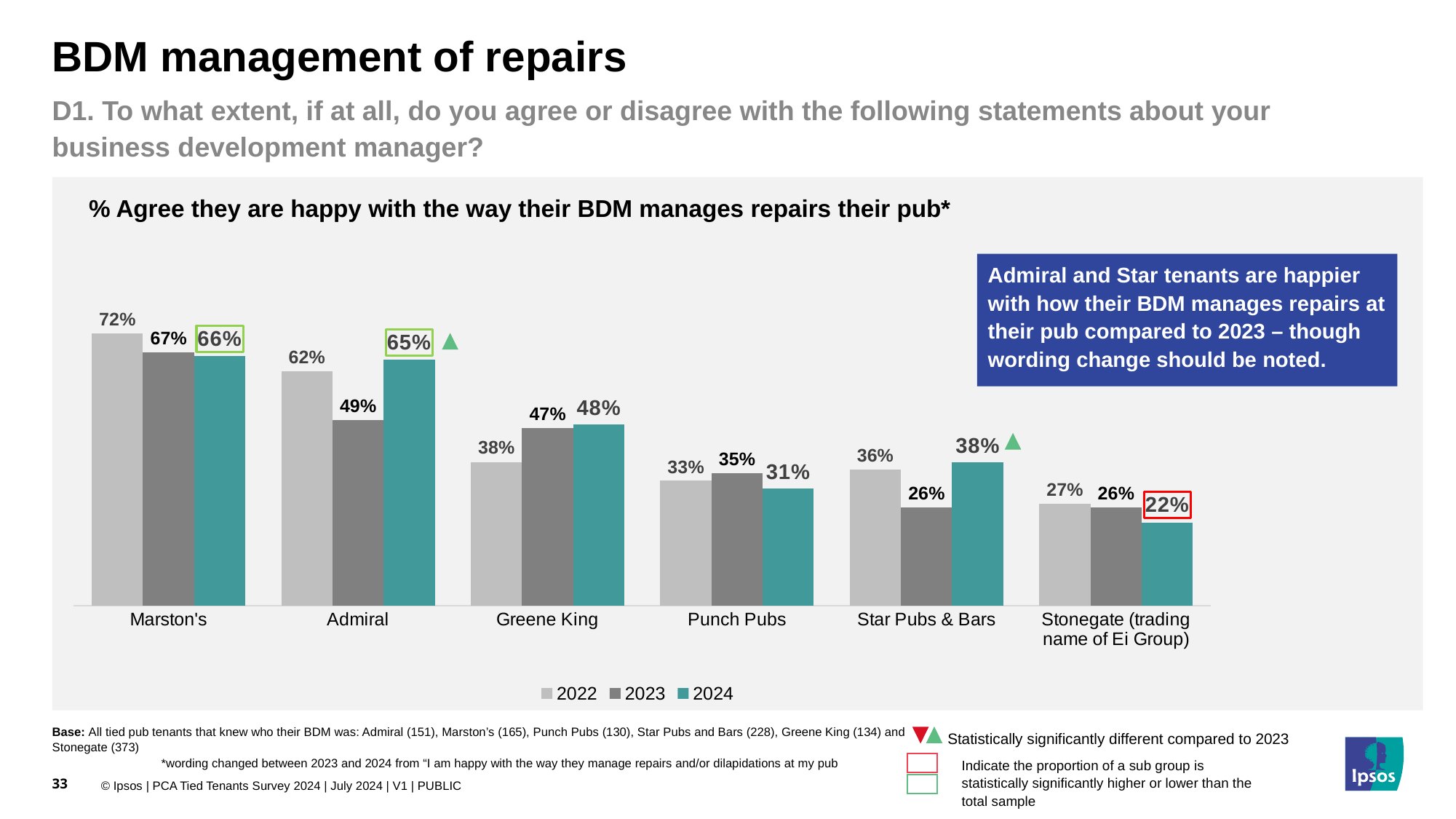
What kind of chart is shown? Bar chart Which years are listed in the legend? 2022, 2023, 2024 Which pub company has the lowest 2022 value? Stonegate (trading name of Ei Group) What is the difference between the 2024 and 2023 values for Admiral? 16 percentage points Which is larger for Punch Pubs: the 2023 value or the 2024 value? 2023 What is the 2024 value for Admiral? 65% How many pub companies are shown on the x axis? 6 What is the 2023 value for Star Pubs & Bars? 26% What is the 2024 value for Stonegate (trading name of Ei Group)? 22% How many series does the legend list? 3 Which pub company has the highest 2024 value? Marston's What is the 2022 value for Marston's? 72%